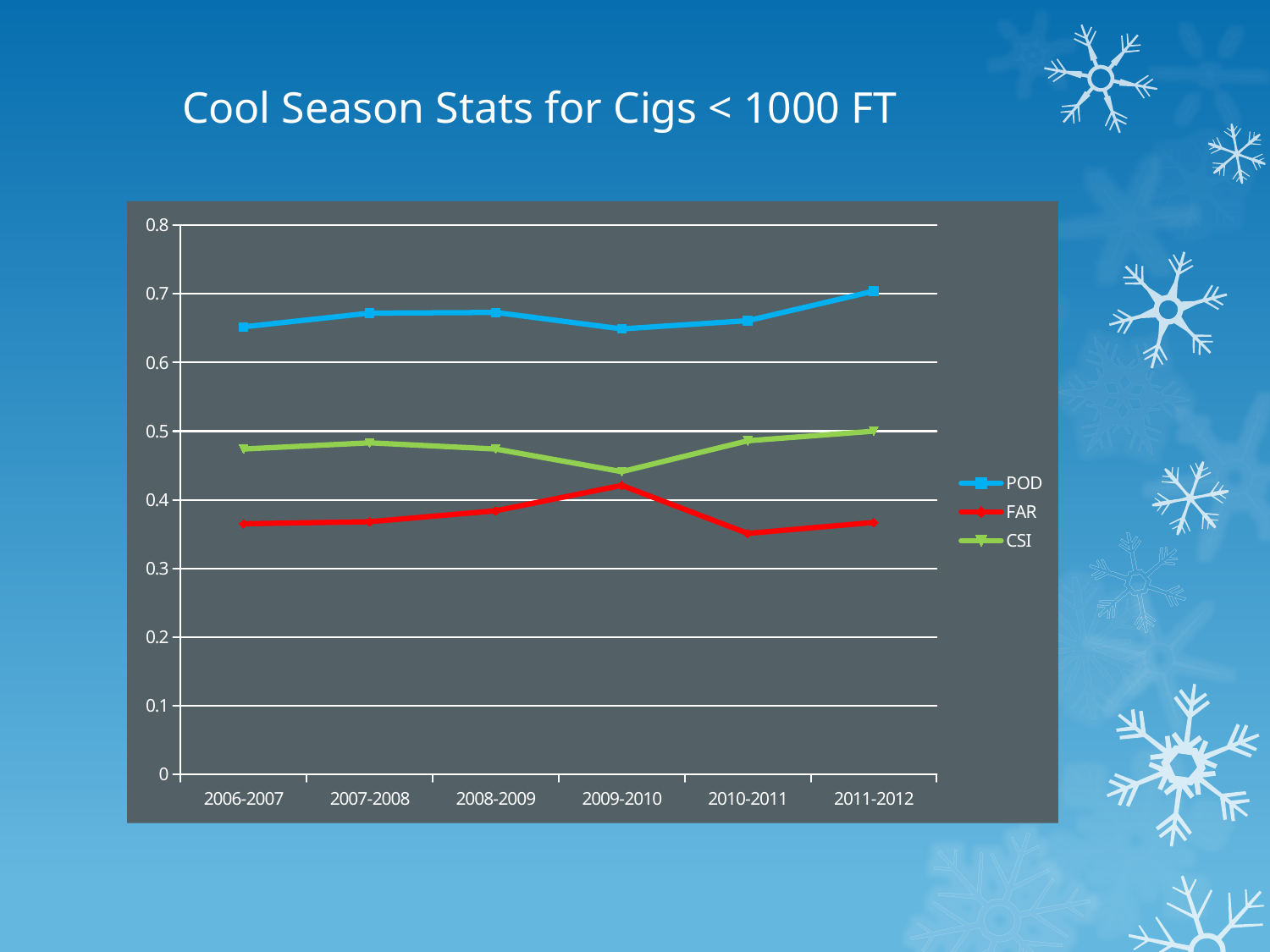
Which is larger in 2008-2009, POD or CSI? POD Is the value of FAR for 2009-2010 greater or less than 0.4? greater How many series does the legend list? 3 In which season is FAR highest? 2009-2010 How many seasons are shown along the x axis? 6 Is the value of FAR for 2010-2011 greater or less than 0.4? less In which season is CSI lowest? 2009-2010 In which season is POD highest? 2011-2012 Is the value of POD for 2006-2007 greater or less than 0.6? greater What kind of chart is shown on the slide? line chart Does POD rise or fall from 2009-2010 to 2011-2012? rise What is the title of the slide? Cool Season Stats for Cigs < 1000 FT